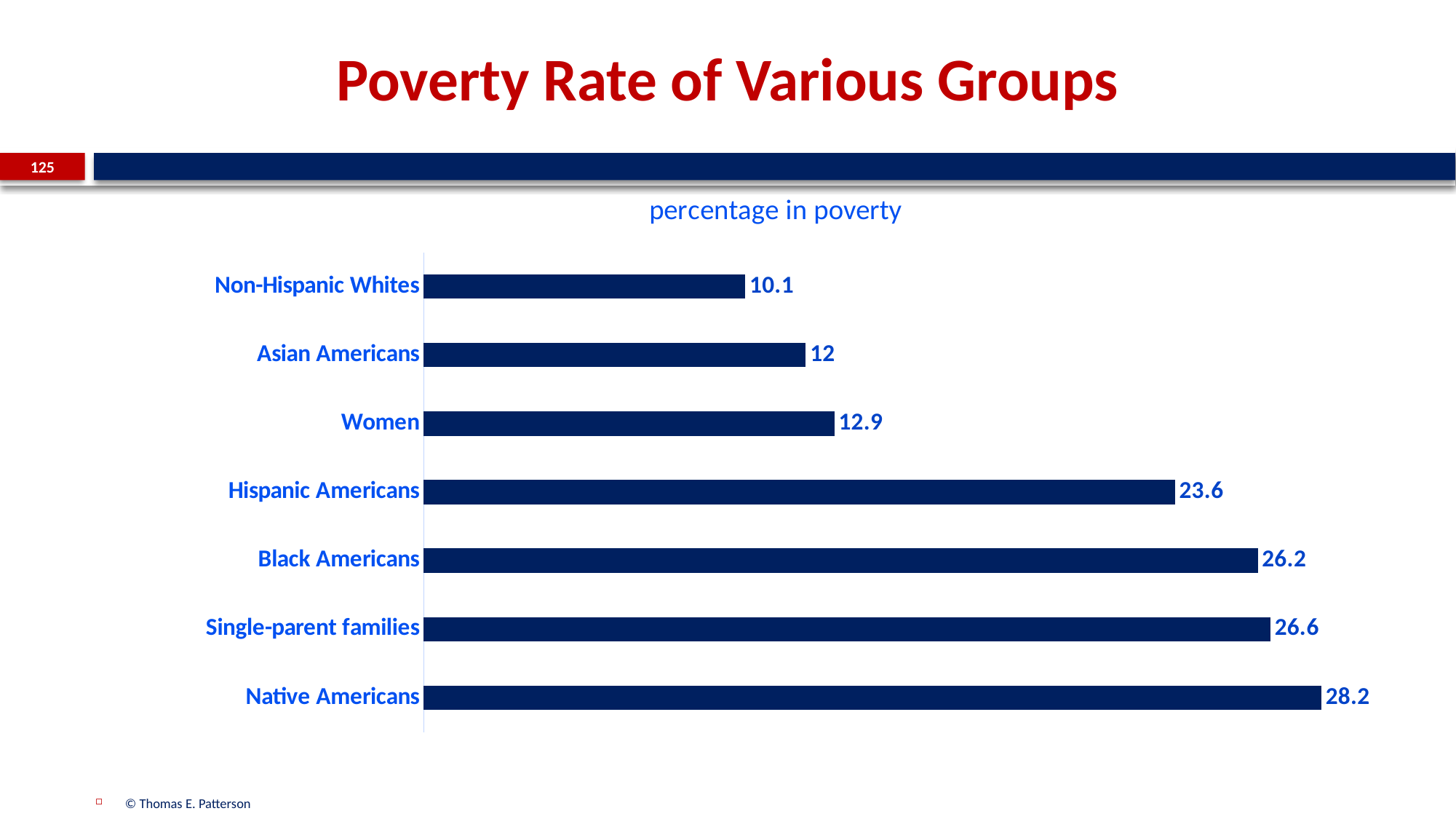
What is the difference between the poverty rate of Native Americans and Non-Hispanic Whites? 18.1 Which has a higher percentage in poverty, Single-parent families or Women? Single-parent families Which has a higher percentage in poverty, Hispanic Americans or Asian Americans? Hispanic Americans What is the percentage in poverty for Hispanic Americans? 23.6 How many groups are shown in the chart? 7 What is the percentage in poverty for Asian Americans? 12 What kind of chart is shown on the slide? Bar chart Which group has the highest percentage in poverty? Native Americans What is the difference between the poverty rate of Black Americans and Hispanic Americans? 2.6 What is the percentage in poverty for Women? 12.9 What is the title of the chart? percentage in poverty Which group has the lowest percentage in poverty? Non-Hispanic Whites